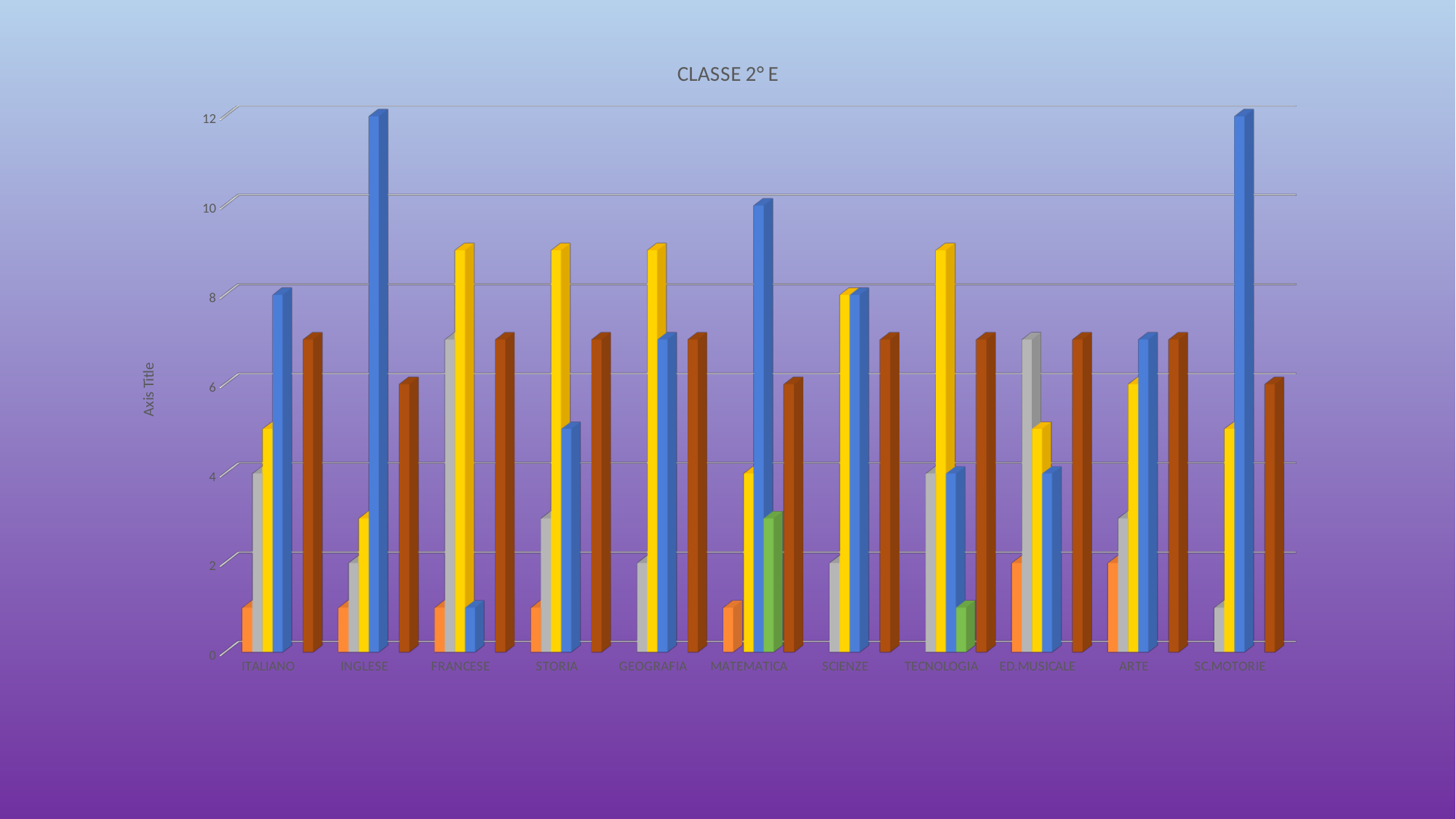
Is the value of the yellow bar for FRANCESE greater or less than 8? greater Is the value of the gray bar for ED.MUSICALE greater or less than 6? greater Is the value of the brown bar for INGLESE greater or less than 8? less Which is larger, the blue bar for INGLESE or the blue bar for ITALIANO? INGLESE Among the blue bars, which category has the lowest value? FRANCESE What is the title of the chart? CLASSE 2° E How many categories are shown on the x axis of the chart? 11 What is the label on the vertical axis of the chart? Axis Title What kind of chart is shown on the slide? bar chart